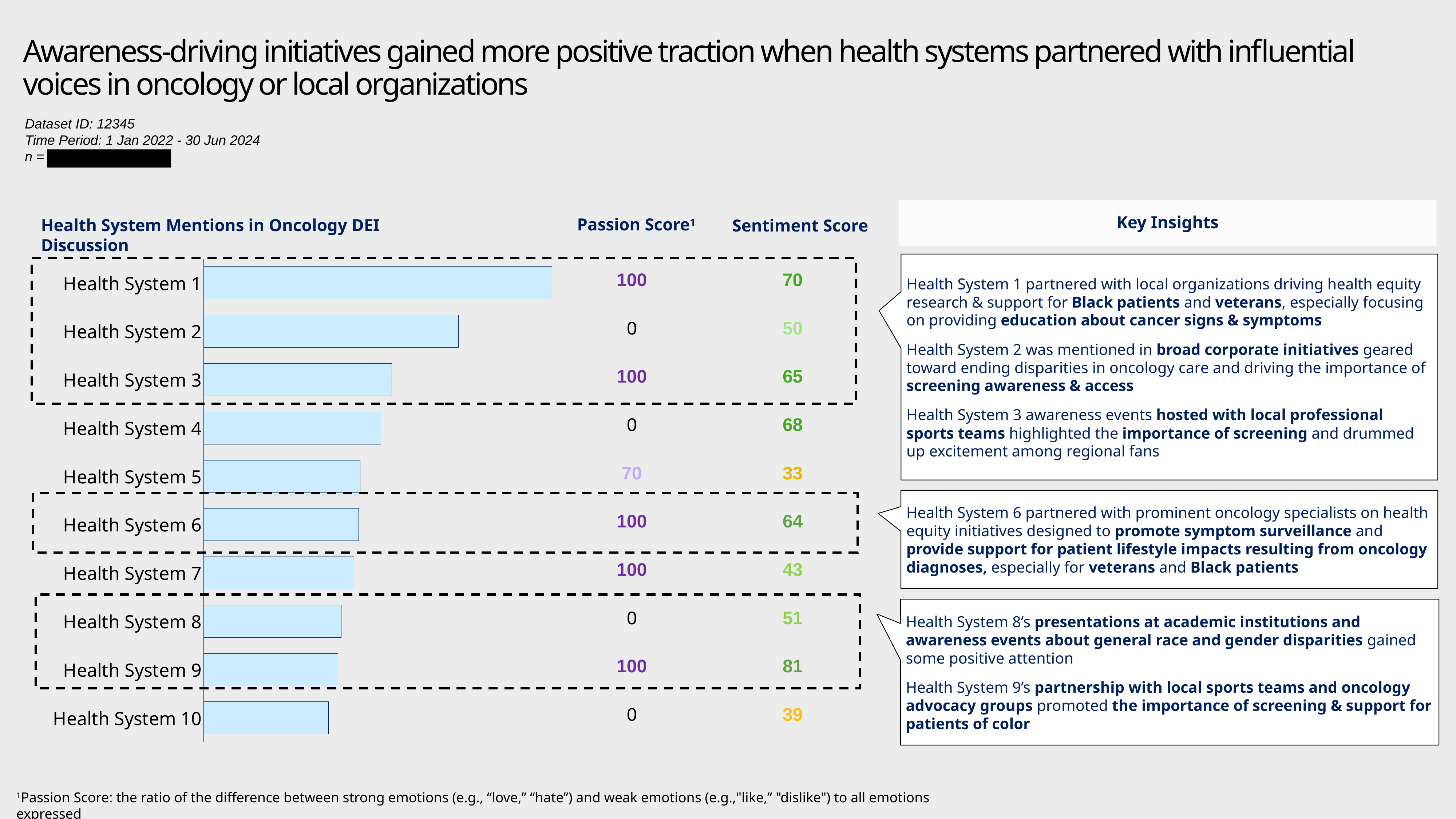
Which health system has the lowest Sentiment Score? Health System 5 How many health systems are shown in the bar chart? 10 Do the bar lengths rise or fall going from Health System 1 down to Health System 10? fall What is the difference between the Sentiment Scores of Health System 9 and Health System 1? 11 What is the Sentiment Score for Health System 1? 70 What is the title of the bar chart? Health System Mentions in Oncology DEI Discussion What kind of chart is used to show Health System Mentions in Oncology DEI Discussion? bar chart Which has more mentions in oncology DEI discussion, Health System 2 or Health System 3? Health System 2 What is the Passion Score for Health System 5? 70 Which health system has the highest Sentiment Score? Health System 9 Which has more mentions in oncology DEI discussion, Health System 4 or Health System 5? Health System 4 Which health system has the longest bar for mentions in oncology DEI discussion? Health System 1